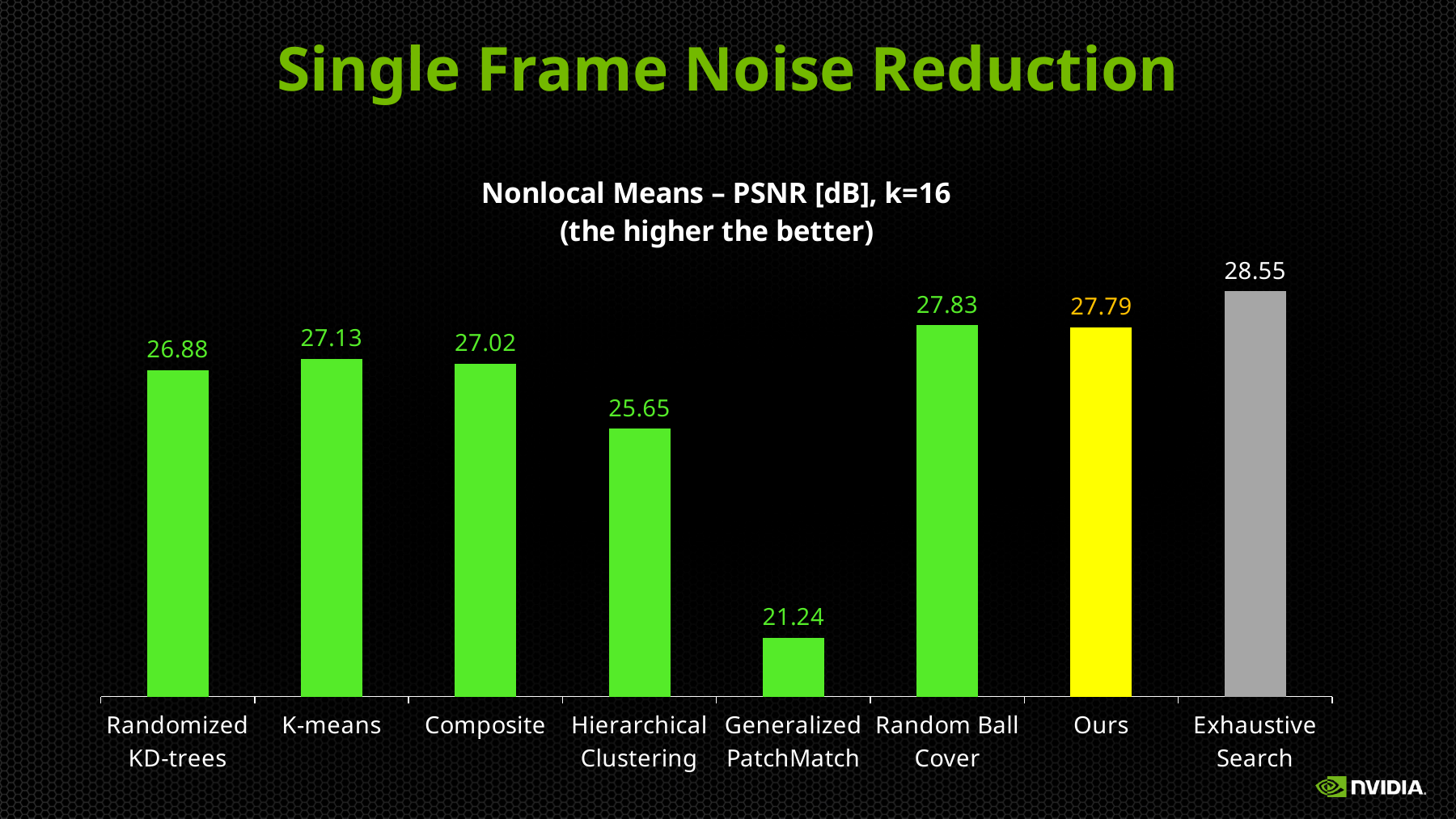
Which has a higher PSNR, Randomized KD-trees or Composite? Composite What kind of chart is shown on the slide? Bar chart What is the PSNR value for Hierarchical Clustering? 25.65 What is the PSNR value for Ours? 27.79 Which method has the lowest PSNR? Generalized PatchMatch What colour is the bar for Ours? Yellow Which method has the highest PSNR? Exhaustive Search What is the PSNR value for K-means? 27.13 What is the PSNR value for Generalized PatchMatch? 21.24 What is the difference in PSNR between Exhaustive Search and Ours? 0.76 What is the difference in PSNR between Random Ball Cover and Generalized PatchMatch? 6.59 How many methods are compared in the chart? 8